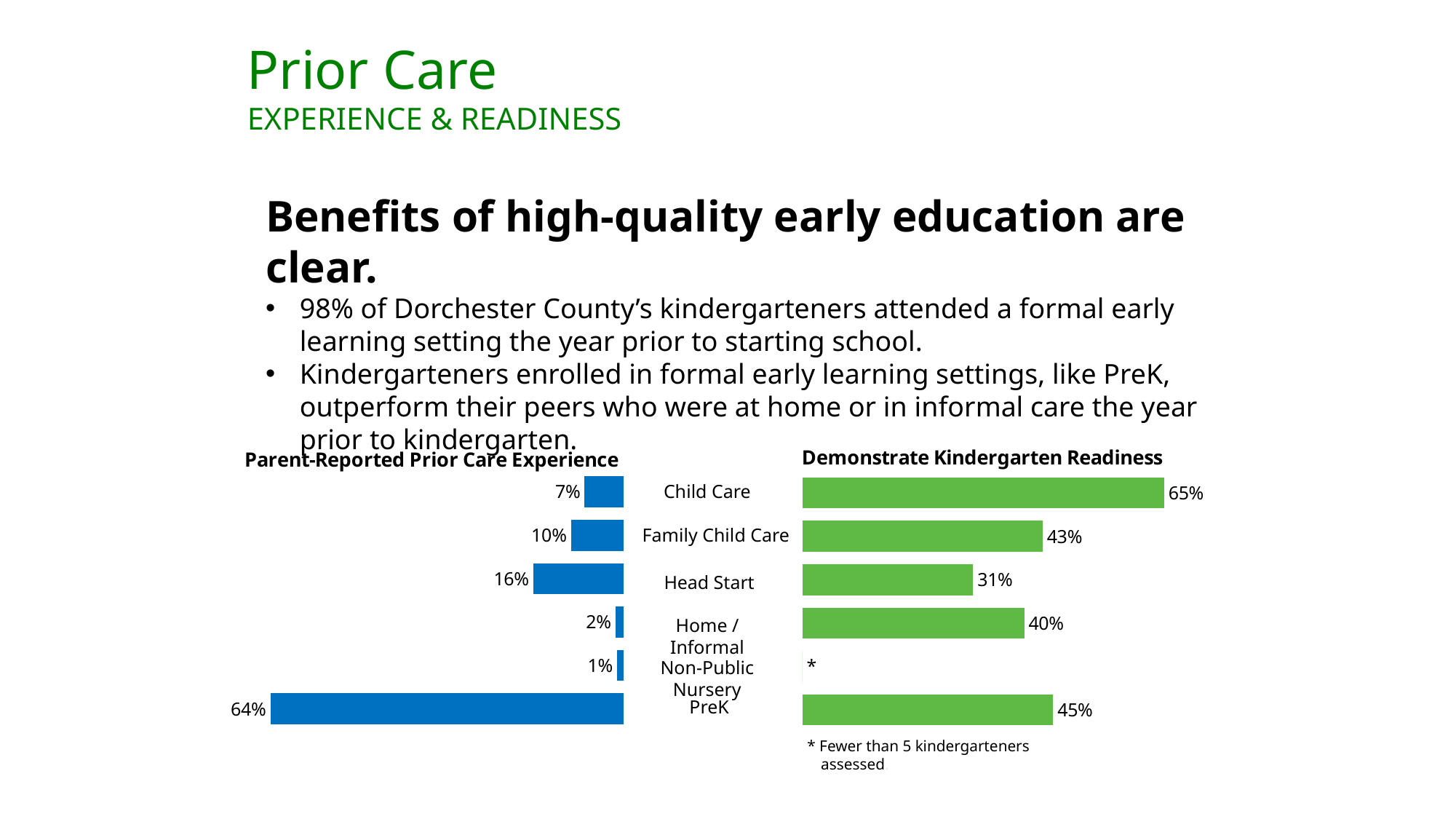
In the Parent-Reported Prior Care Experience chart, which category has the highest value? PreK What type of chart is the Demonstrate Kindergarten Readiness chart? Bar chart In the Demonstrate Kindergarten Readiness chart, what is the difference between Child Care and PreK? 20% In the Parent-Reported Prior Care Experience chart, what percentage is shown for Head Start? 16% In the Parent-Reported Prior Care Experience chart, which is larger: Family Child Care or Child Care? Family Child Care In the Parent-Reported Prior Care Experience chart, which category has the lowest value? Non-Public Nursery In the Demonstrate Kindergarten Readiness chart, what percentage is shown for Home / Informal? 40% In the Demonstrate Kindergarten Readiness chart, which is larger: Family Child Care or Home / Informal? Family Child Care In the Parent-Reported Prior Care Experience chart, what percentage is shown for PreK? 64% In the Demonstrate Kindergarten Readiness chart, what percentage is shown for Child Care? 65% In the Demonstrate Kindergarten Readiness chart, why is no value shown for Non-Public Nursery? Fewer than 5 kindergarteners assessed In the Demonstrate Kindergarten Readiness chart, which labeled category has the lowest value? Head Start